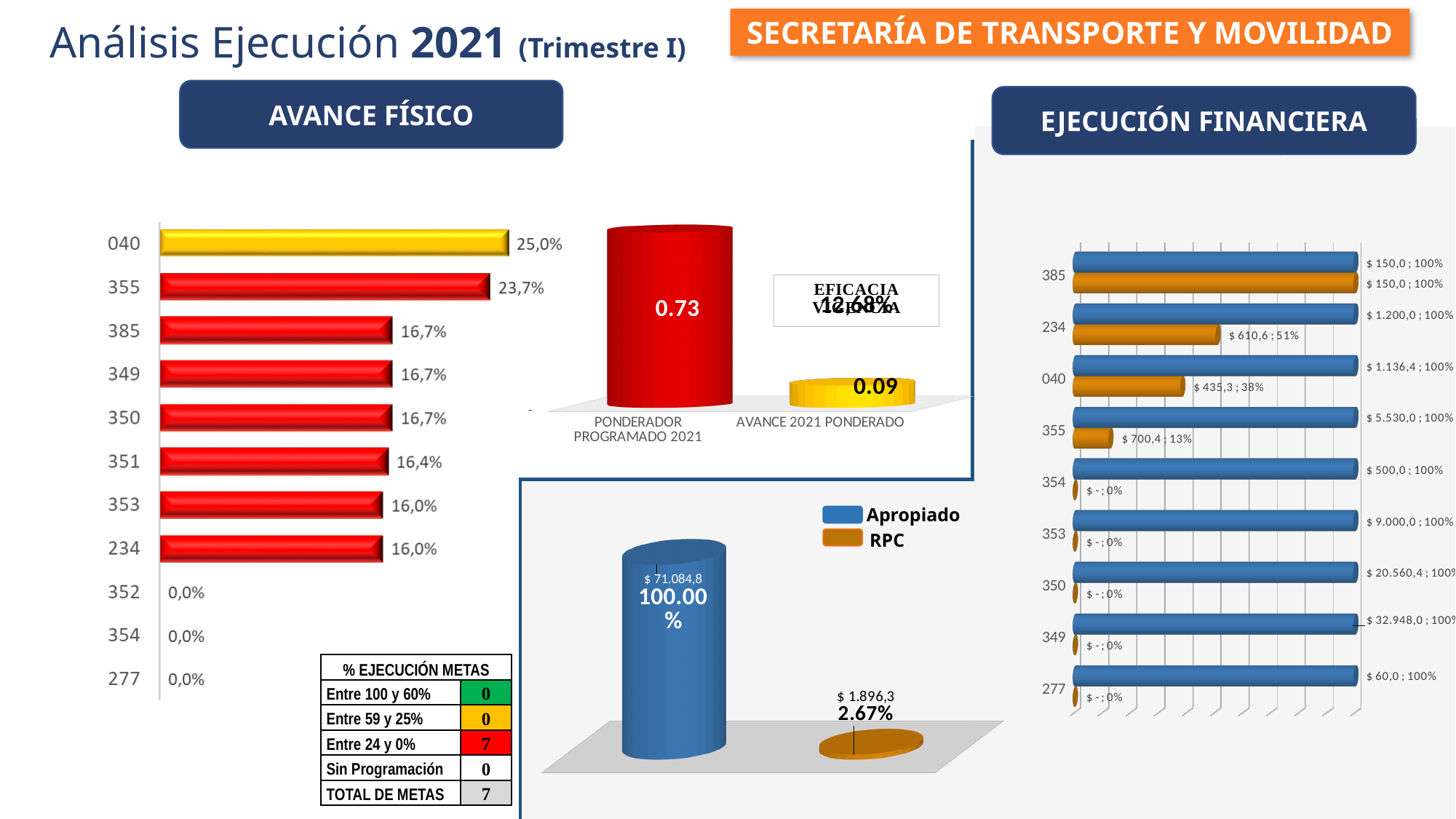
In the left 'AVANCE FÍSICO' bar chart, what is the difference between the values for 040 and 355? 1,3% In the right 'EJECUCIÓN FINANCIERA' bar chart, how many series does the legend list? 2 In the left 'AVANCE FÍSICO' bar chart, which category has the highest value? 040 In the middle chart with 'PONDERADOR PROGRAMADO 2021' and 'AVANCE 2021 PONDERADO', what is the value for PONDERADOR PROGRAMADO 2021? 0.73 In the bottom-centre chart with the Apropiado and RPC legend, what percentage is shown for RPC? 2.67% In the right 'EJECUCIÓN FINANCIERA' bar chart, what is the RPC value for category 234? $ 610,6 ; 51% In the bottom-centre chart with the Apropiado and RPC legend, what amount is shown for Apropiado? $ 71.084,8 In the left 'AVANCE FÍSICO' bar chart, how many categories are shown? 11 In the left 'AVANCE FÍSICO' bar chart, what is the value for category 351? 16,4% In the middle chart with 'PONDERADOR PROGRAMADO 2021' and 'AVANCE 2021 PONDERADO', which of the two values is larger? PONDERADOR PROGRAMADO 2021 In the right 'EJECUCIÓN FINANCIERA' bar chart, which category has the highest Apropiado value? 349 In the left 'AVANCE FÍSICO' bar chart, what is the value for category 040? 25,0%